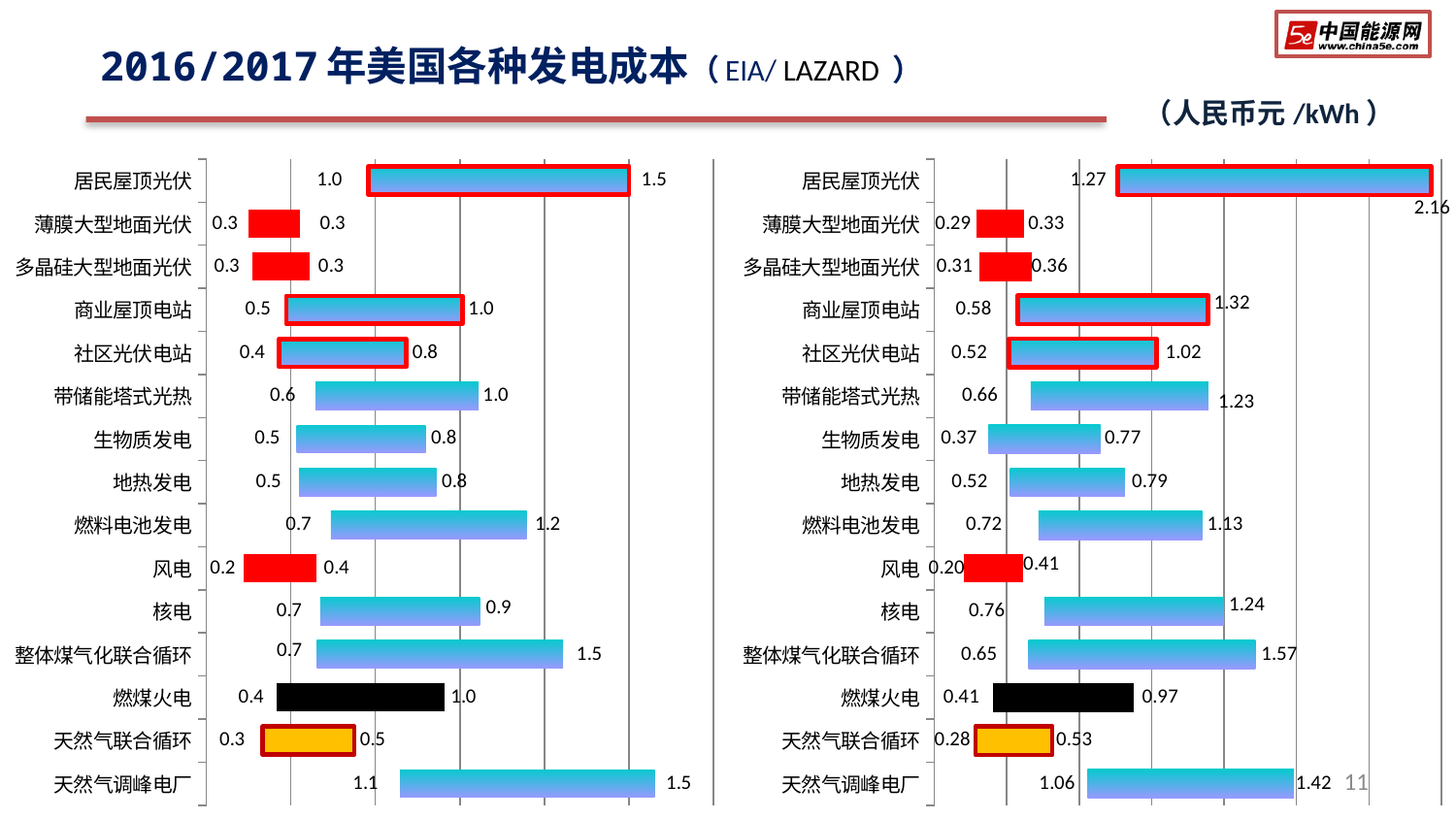
In the right chart, what is the difference between the upper and lower values for 居民屋顶光伏? 0.89 In the right chart, what is the upper value shown for 居民屋顶光伏? 2.16 In the right chart, which category has the lowest lower value? 风电 What kind of chart is shown on the left of the slide? Bar chart In the right chart, which category has the highest upper value? 居民屋顶光伏 How many categories are listed in the left chart? 15 In the left chart, what is the difference between the upper and lower values for 整体煤气化联合循环? 0.8 In the right chart, which has the larger upper value, 燃煤火电 or 核电? 核电 What unit is stated for the values on the slide? 人民币元/kWh In the left chart, what are the lower and upper values shown for 天然气调峰电厂? 1.1 and 1.5 In the right chart, what is the lower value shown for 核电? 0.76 In the left chart, what is the upper value shown for 燃料电池发电? 1.2